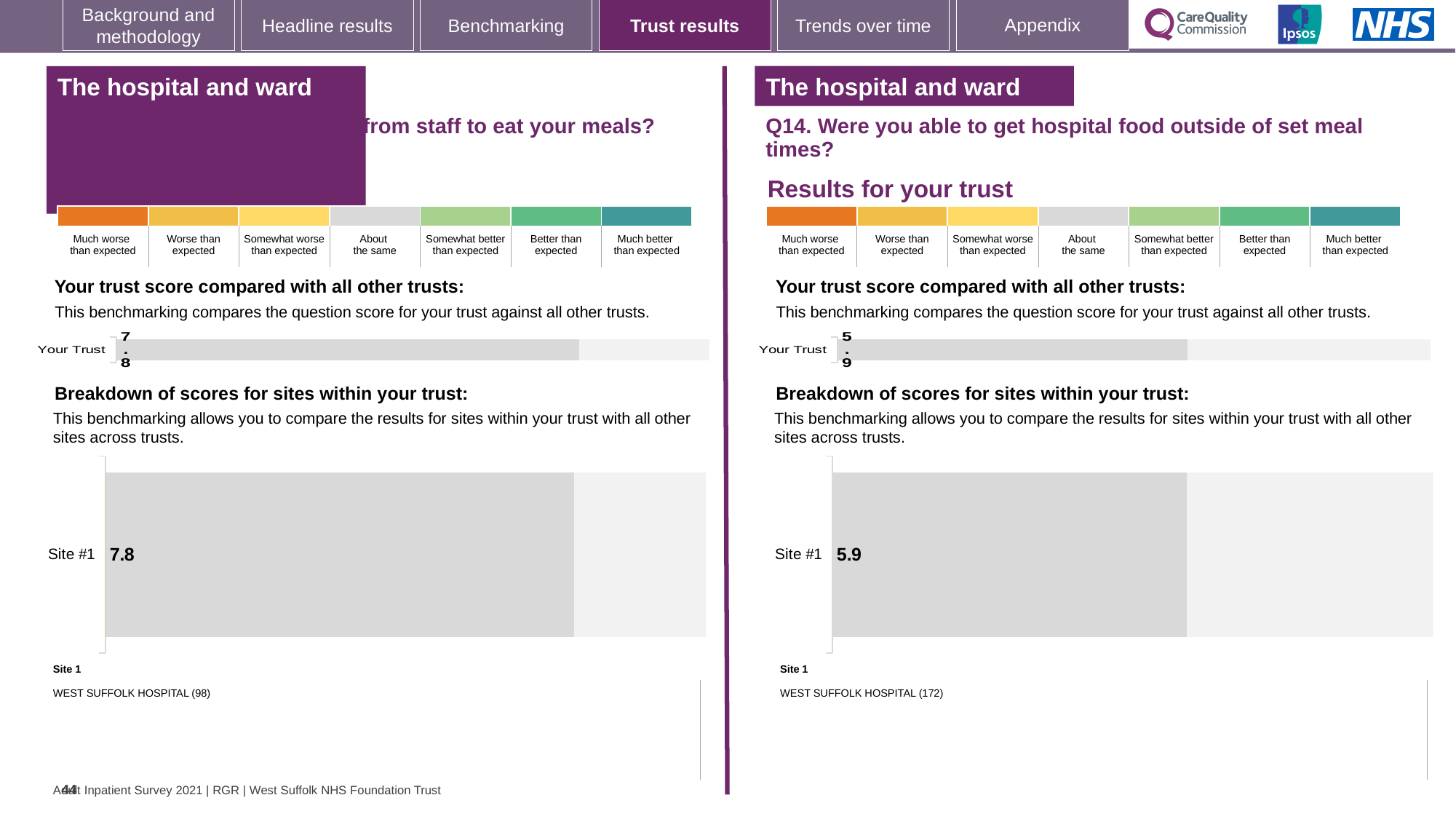
On the left-hand chart (question about help from staff to eat your meals), what is the score shown for Your Trust? 7.8 What is the difference between the Site #1 score on the left-hand chart (7.8) and the Site #1 score on the right-hand Q14 chart (5.9)? 1.9 On the right-hand chart for Q14 (hospital food outside of set meal times), what is the score shown for Your Trust? 5.9 In the right-hand 'Breakdown of scores for sites within your trust' chart for Q14, what is the score for Site #1? 5.9 How many sites are shown in the right-hand 'Breakdown of scores for sites within your trust' chart for Q14? 1 In the left-hand 'Breakdown of scores for sites within your trust' chart, what is the score for Site #1? 7.8 What type of chart is used to show the Site #1 score in the right-hand breakdown for Q14? Bar chart Which hospital is listed as Site 1 on the right-hand Q14 chart? WEST SUFFOLK HOSPITAL (172) Which hospital is listed as Site 1 on the left-hand chart? WEST SUFFOLK HOSPITAL (98) Which is larger: the Your Trust score on the left-hand chart or the Your Trust score on the right-hand Q14 chart? The left-hand chart (7.8) How many sites are shown in the left-hand 'Breakdown of scores for sites within your trust' chart? 1